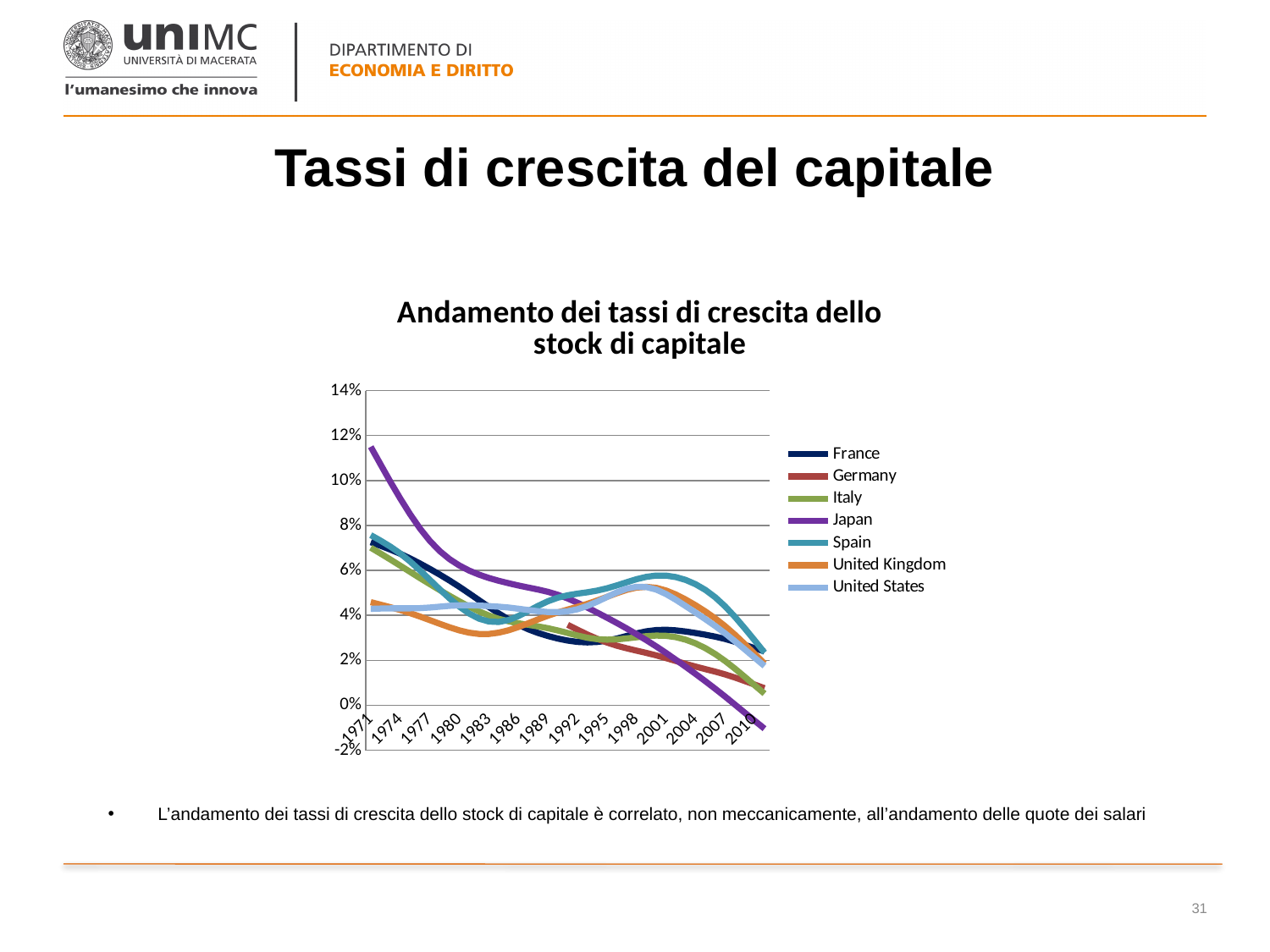
How many series does the legend list? 7 Which series has the lowest value in 2010? Japan Is the value for Germany in 2010 greater or less than 2%? less What kind of chart is shown on the slide? line chart Is the value for Japan in 2010 greater or less than 0%? less Which series has the highest value in 1971? Japan Which countries are listed in the chart legend? France, Germany, Italy, Japan, Spain, United Kingdom, United States In 1971, which is larger: the value for Japan or the value for United Kingdom? Japan What is the title of the chart? Andamento dei tassi di crescita dello stock di capitale Is the value for Spain in 1971 greater or less than 6%? greater Does the Japan series rise or fall from 1971 to 2010? fall